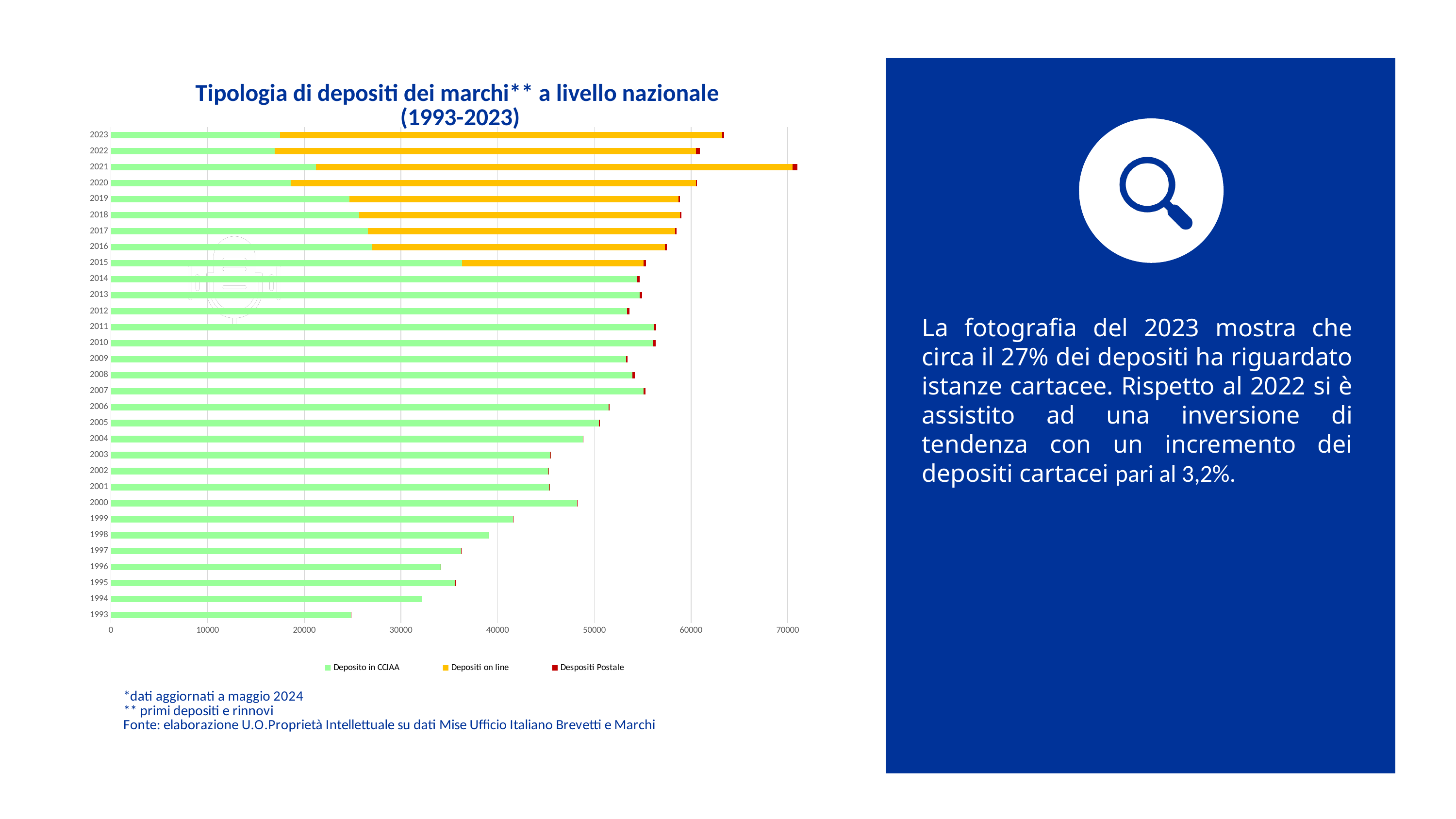
Is the total value for 1993 greater or less than 30000? less Which year has the longest total bar? 2021 How many series does the legend list? 3 Is the total value for 2021 greater or less than 60000? greater Which year has the shortest total bar? 1993 Is the total value for 2023 greater or less than 60000? greater What is the title of the chart? Tipologia di depositi dei marchi** a livello nazionale (1993-2023) Which year has the larger total bar, 2021 or 2023? 2021 How many years (categories) are plotted on the chart? 31 What kind of chart is shown on the slide? Stacked horizontal bar chart Which year has the larger 'Deposito in CCIAA' segment, 2015 or 2016? 2015